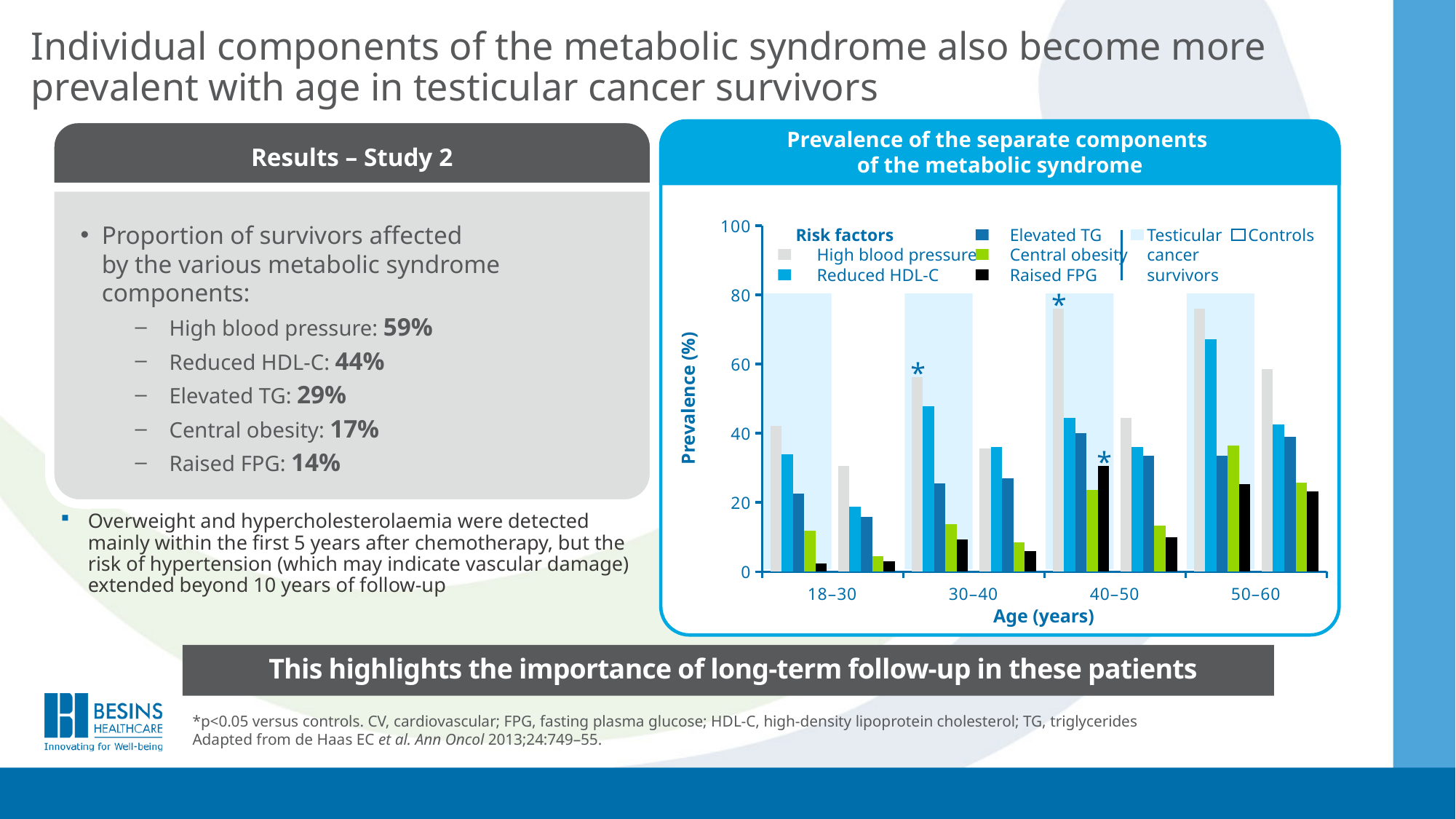
Is the prevalence of reduced HDL-C in testicular cancer survivors aged 50–60 greater or less than 60? greater Is the prevalence of raised FPG in testicular cancer survivors aged 18–30 greater or less than 20? less In the 40–50 age group, is the prevalence of high blood pressure higher in testicular cancer survivors or in controls? Testicular cancer survivors Is the prevalence of central obesity in testicular cancer survivors aged 40–50 greater or less than 40? less How many risk factors does the chart legend list? 5 What kind of chart is shown under the title 'Prevalence of the separate components of the metabolic syndrome'? Bar chart What is the label of the x axis of the chart? Age (years) What is the label of the y axis of the chart? Prevalence (%) How many age groups are shown on the x axis of the chart? 4 Among testicular cancer survivors aged 18–30, which risk factor has the lowest prevalence? Raised FPG Among testicular cancer survivors aged 18–30, which risk factor has the highest prevalence? High blood pressure